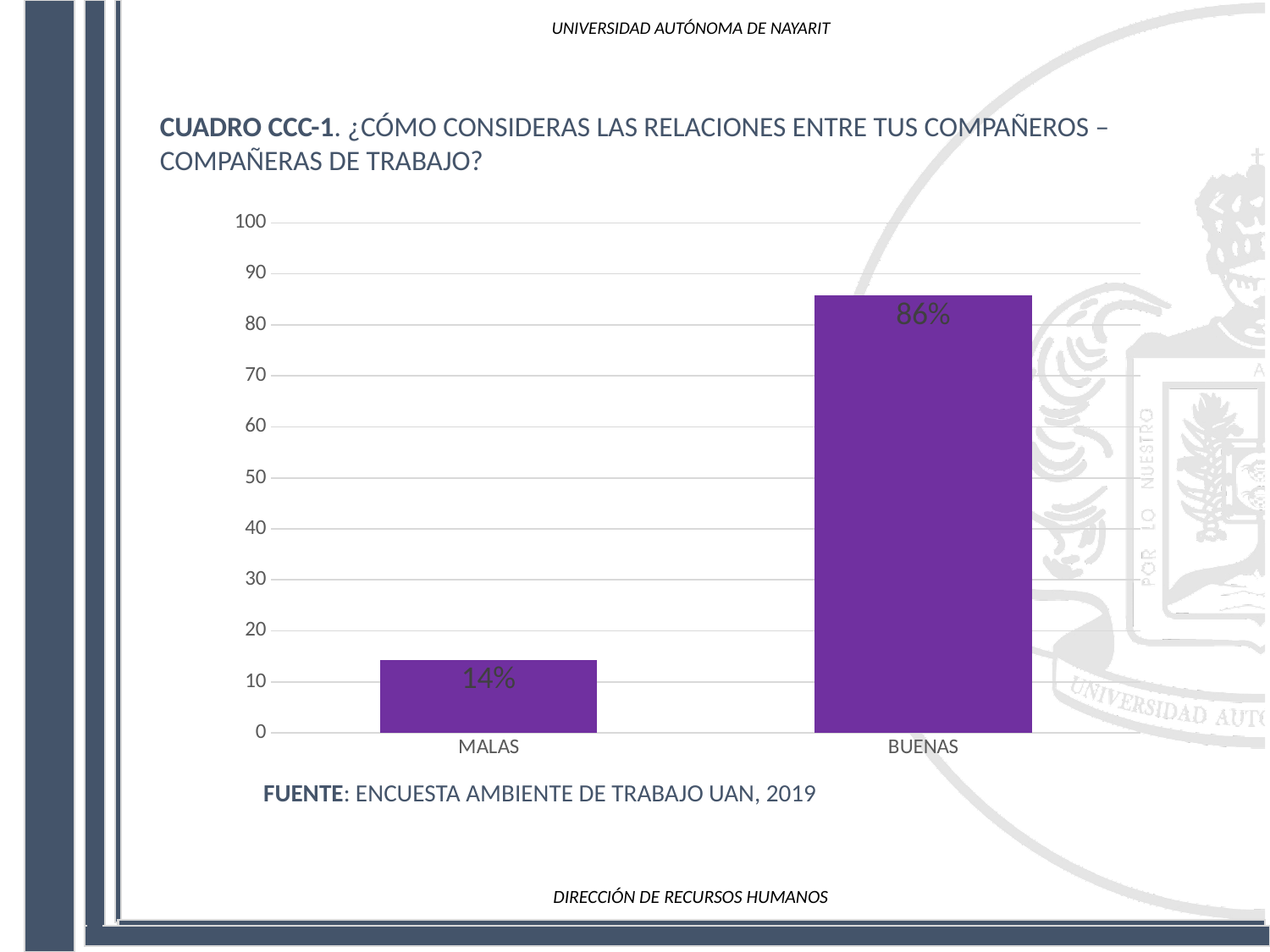
What is the source cited below the chart? ENCUESTA AMBIENTE DE TRABAJO UAN, 2019 Which category has the lowest value? MALAS What kind of chart is shown on the slide? bar chart Is the value for BUENAS greater or less than 80? greater What is the value for BUENAS? 86% What is the difference between the values for BUENAS and MALAS? 72% What is the value for MALAS? 14% What is the maximum value shown on the vertical axis? 100 Which category has the highest value? BUENAS Which is larger, the value for MALAS or the value for BUENAS? BUENAS Is the value for MALAS greater or less than 20? less How many categories are shown in the chart? 2